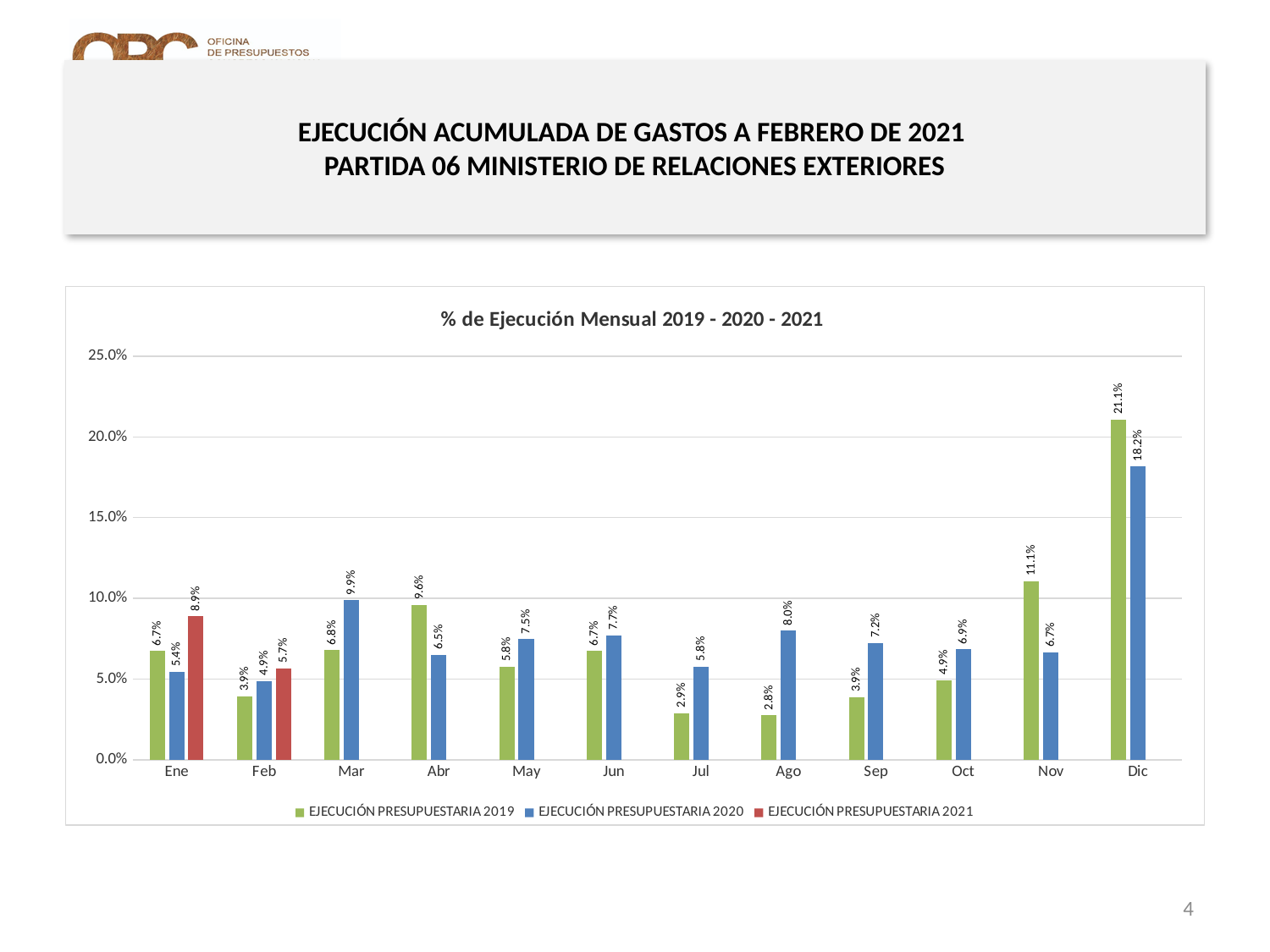
How many months are shown on the x axis? 12 What kind of chart is shown on the slide? Bar chart How many series does the legend list? 3 What is the value for EJECUCIÓN PRESUPUESTARIA 2020 in Mar? 9.9% What is the value for EJECUCIÓN PRESUPUESTARIA 2021 in Ene? 8.9% What is the difference between EJECUCIÓN PRESUPUESTARIA 2019 and EJECUCIÓN PRESUPUESTARIA 2020 in Dic? 2.9% Which is larger in Ago: EJECUCIÓN PRESUPUESTARIA 2019 or EJECUCIÓN PRESUPUESTARIA 2020? EJECUCIÓN PRESUPUESTARIA 2020 Is the value for EJECUCIÓN PRESUPUESTARIA 2020 in Dic greater or less than 15.0%? greater Which month has the lowest value for EJECUCIÓN PRESUPUESTARIA 2019? Ago Which month has the lowest value for EJECUCIÓN PRESUPUESTARIA 2020? Feb Which month has the highest value for EJECUCIÓN PRESUPUESTARIA 2019? Dic What is the value for EJECUCIÓN PRESUPUESTARIA 2019 in Nov? 11.1%